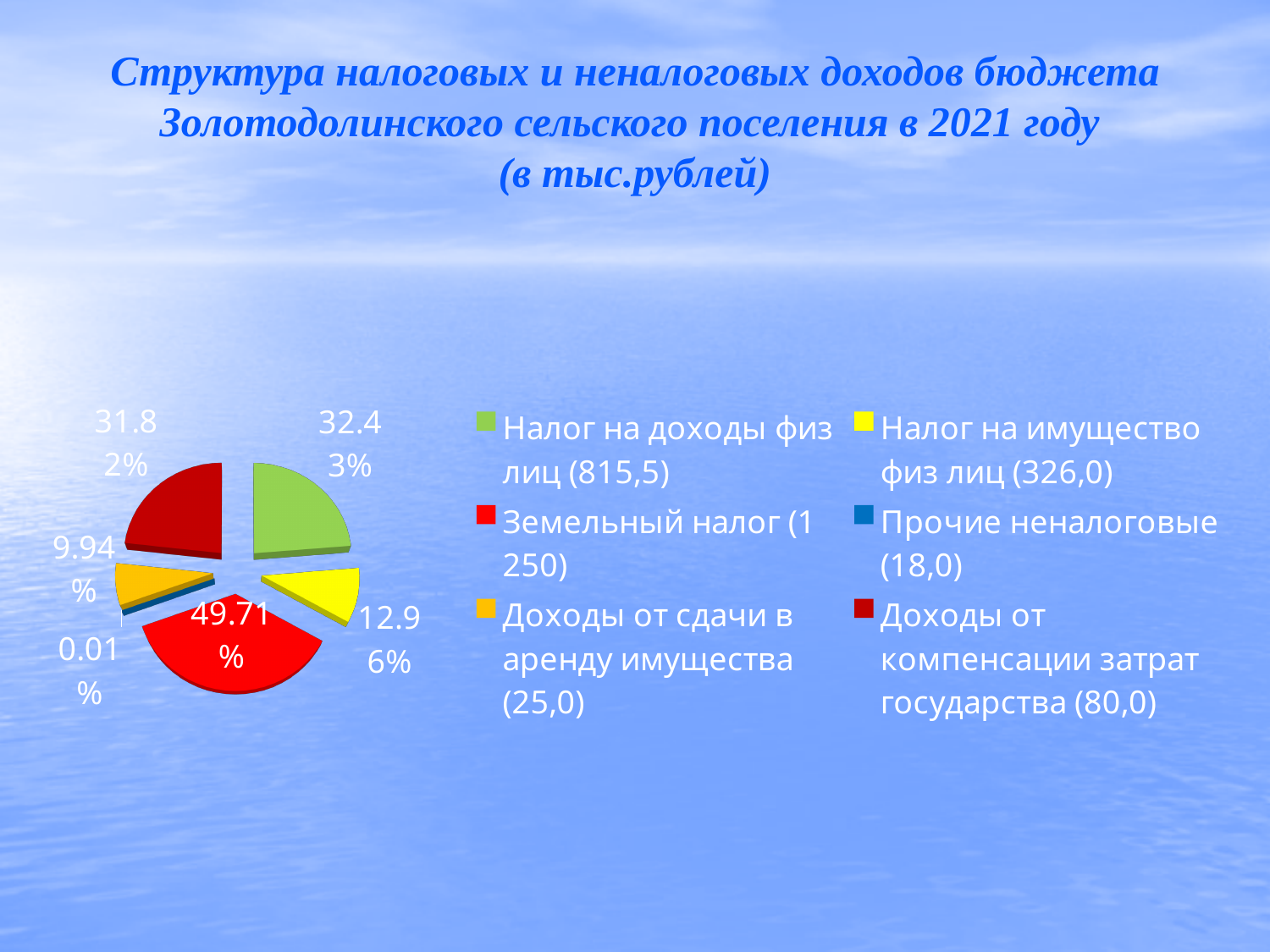
What is the difference in percentage points between the Земельный налог slice (49.71%) and the Доходы от сдачи в аренду имущества slice (9.94%)? 39.77 What percentage is shown for the Доходы от сдачи в аренду имущества slice? 9.94% What percentage is shown for the Прочие неналоговые slice? 0.01% What kind of chart is shown on the slide? pie chart Which category has the smallest slice of the pie? Прочие неналоговые What value in thousand rubles does the legend give for Налог на имущество физ лиц? 326,0 How many categories does the legend of the pie chart list? 6 What colour is the Земельный налог slice in the pie chart? red What percentage is shown for the Земельный налог slice? 49.71% Which category has the largest slice of the pie? Земельный налог What value in thousand rubles does the legend give for Земельный налог? 1 250 Which slice is larger: Земельный налог or Налог на доходы физ лиц? Земельный налог